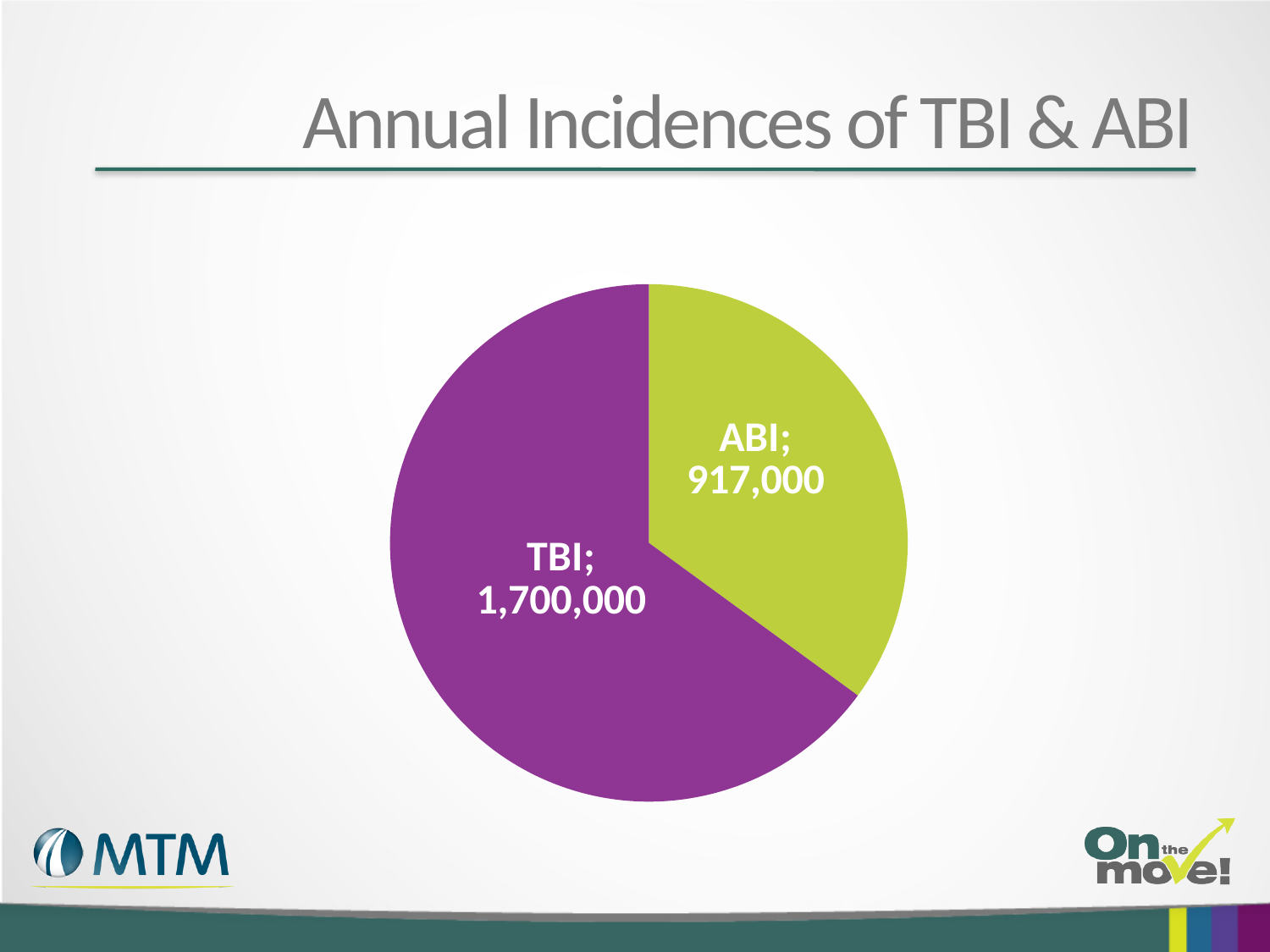
What is the title of the slide containing the pie chart? Annual Incidences of TBI & ABI What colour is the ABI slice of the pie chart? Green Which is larger, the value for TBI or the value for ABI? TBI Which category has the smallest slice of the pie chart? ABI Which category has the largest slice of the pie chart? TBI What is the combined total of the TBI and ABI values? 2,617,000 What kind of chart is shown on the slide? Pie chart What is the value shown for ABI in the pie chart? 917,000 What is the value shown for TBI in the pie chart? 1,700,000 To the nearest whole percent, what share of the pie does TBI represent? 65% What is the difference between the TBI and ABI values? 783,000 How many slices does the pie chart have? 2